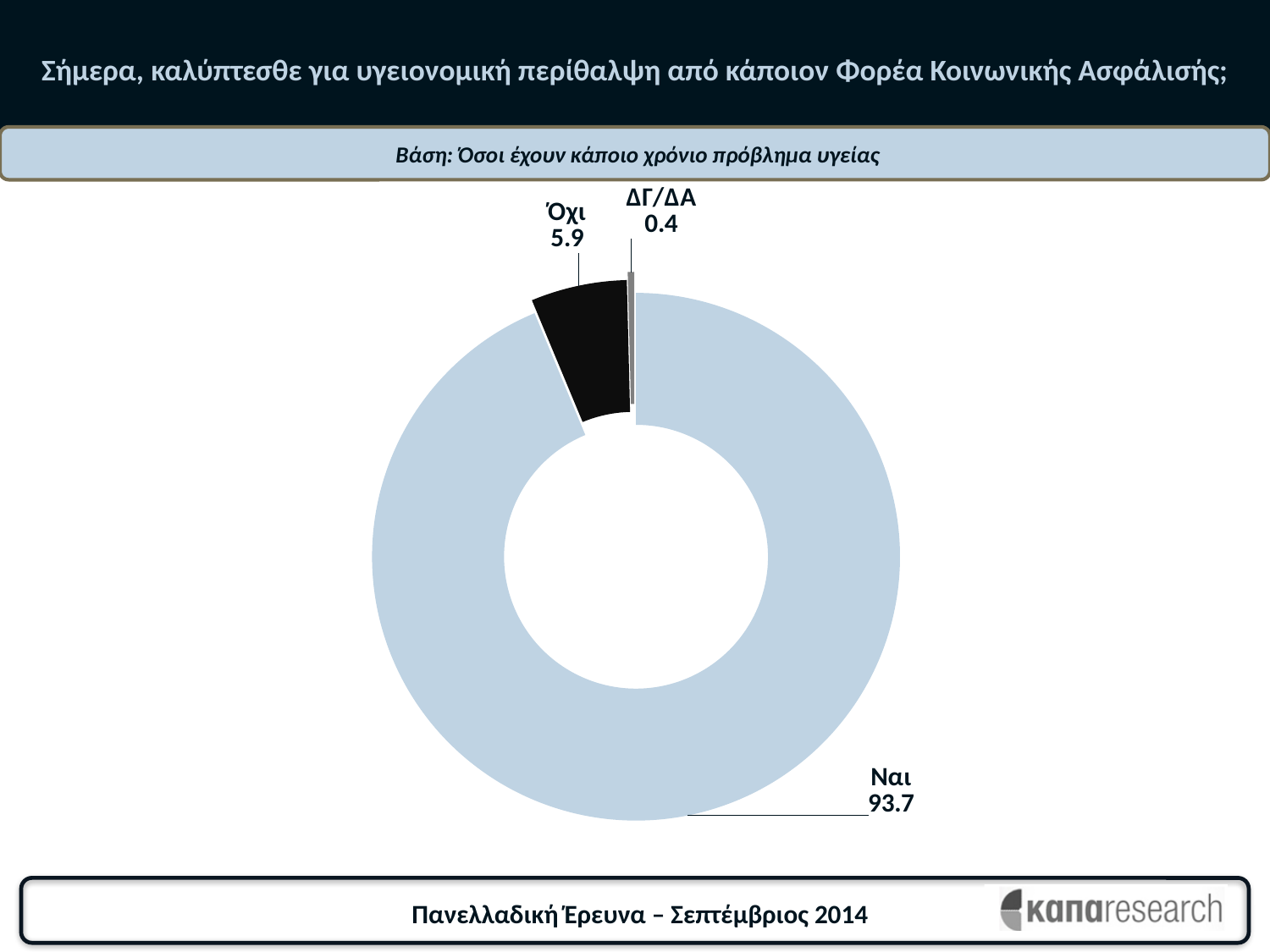
What value is shown for the "Όχι" slice? 5.9 What value is shown for the "Ναι" slice? 93.7 What is the difference between the values for "Ναι" and "Όχι"? 87.8 What share of the chart does the "Ναι" slice represent? 93.7 What colour is the "Όχι" slice? Black What is the difference between the values for "Όχι" and "ΔΓ/ΔΑ"? 5.5 How many categories (slices) does the chart show? 3 What kind of chart is shown on the slide? Doughnut (pie) chart Which is larger, the value for "Όχι" or the value for "ΔΓ/ΔΑ"? Όχι What value is shown for the "ΔΓ/ΔΑ" slice? 0.4 Which category has the smallest slice? ΔΓ/ΔΑ Which category has the largest slice? Ναι